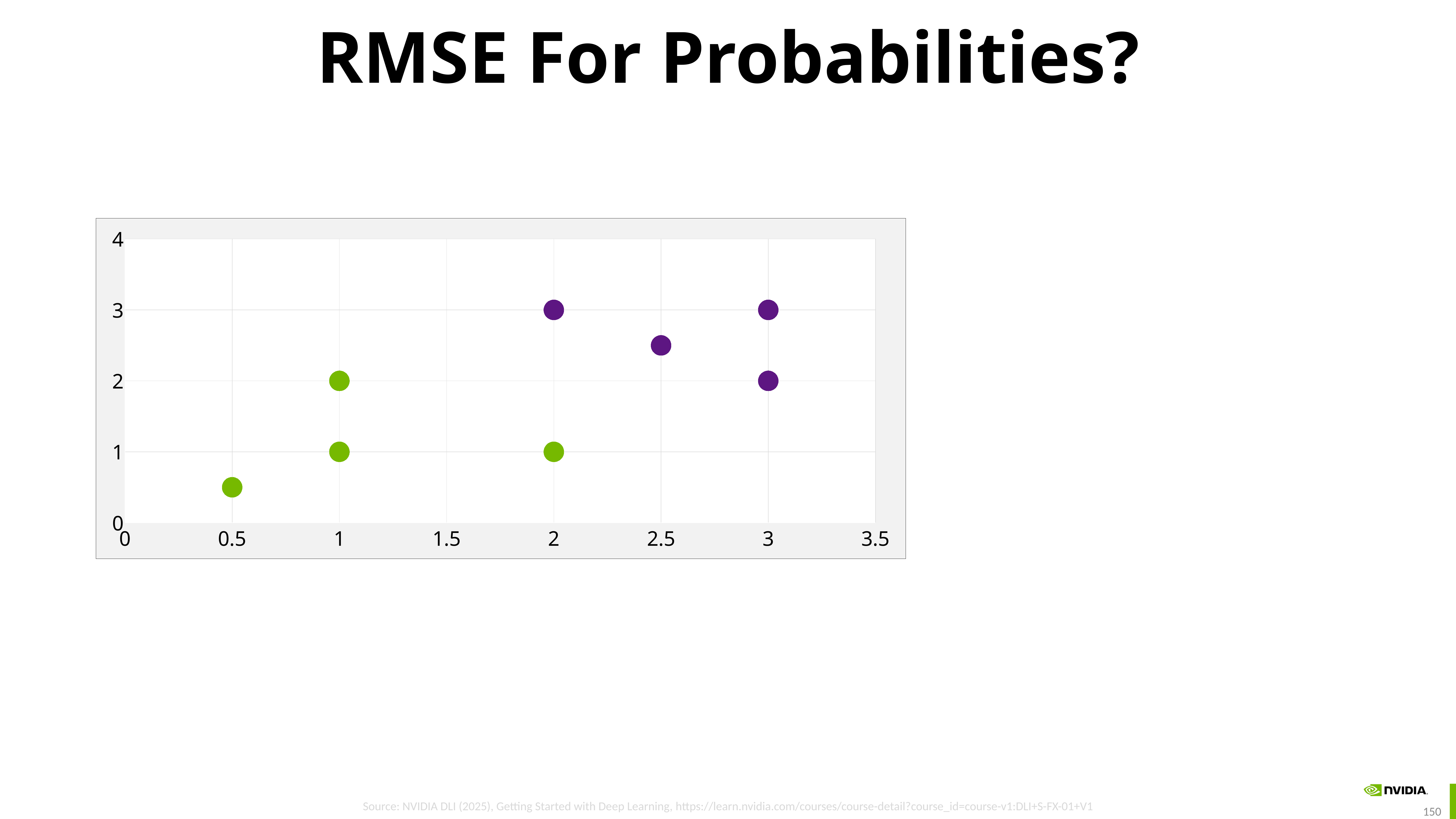
How many purple points are plotted on the chart? 4 What is the highest y value reached by any point on the chart? 3 What kind of chart is shown on the slide? scatter chart What is the y value of the purple point at x = 2? 3 What is the title of the slide containing the chart? RMSE For Probabilities? Is the y value of the purple point at x = 2.5 greater or less than 2? greater Which point has a larger y value: the green point at x = 2 or the purple point at x = 2? the purple point Is the y value of the green point at x = 0.5 greater or less than 1? less What is the y value of the green point at x = 2? 1 What colour is the lowest point on the chart? green How many green points are plotted on the chart? 4 How many data points are plotted on the chart? 8